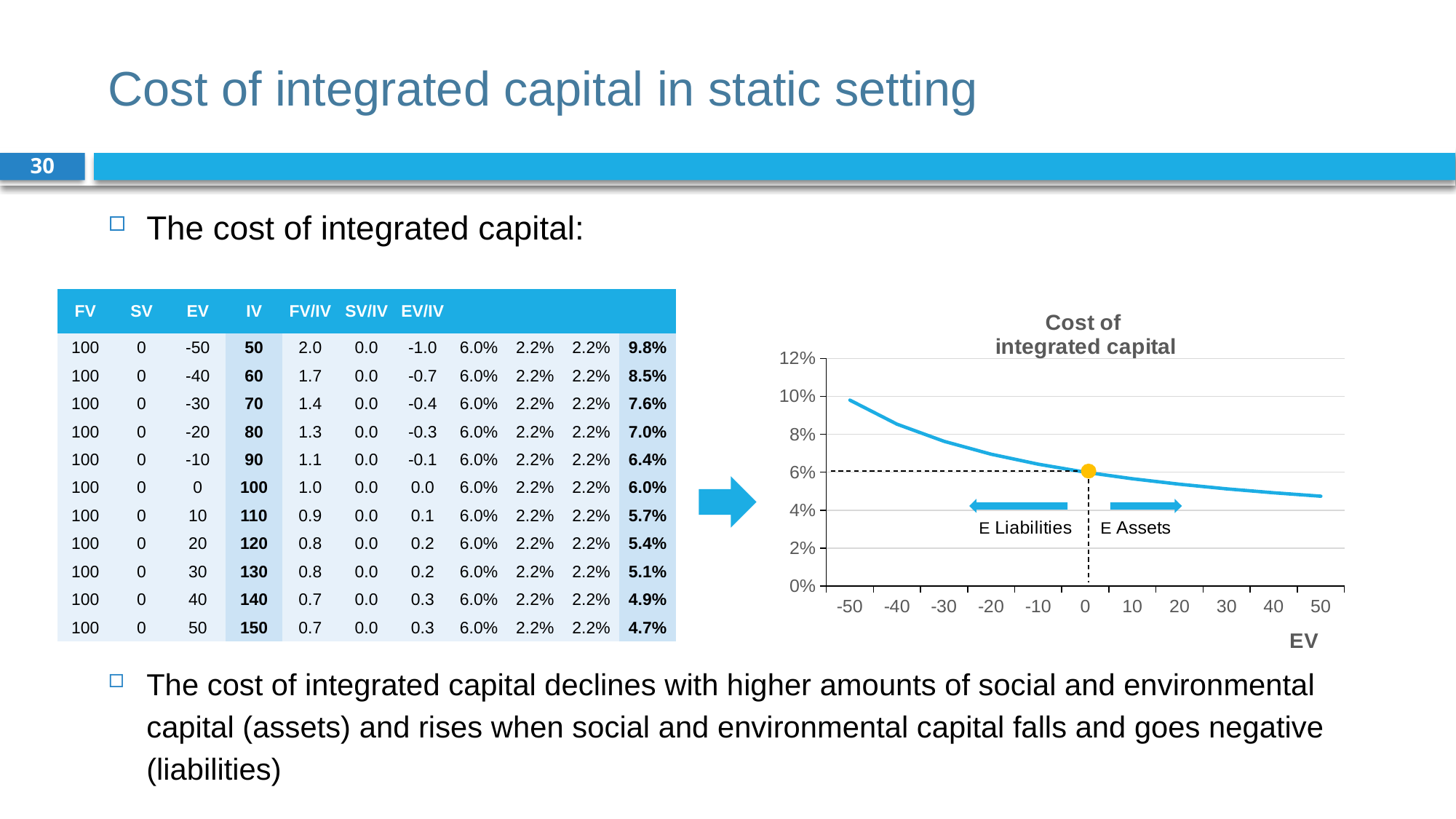
What kind of chart is shown on the slide? line chart At which EV value is the cost of integrated capital highest on the chart? -50 What two labels appear beside the arrows below the curve on the chart? E Liabilities and E Assets Is the cost of integrated capital at EV = -50 greater or less than 8%? greater Does the cost of integrated capital rise or fall as EV increases along the x axis? fall How many tick labels are shown on the EV axis of the chart? 11 Is the cost of integrated capital at EV = 50 greater or less than 6%? less Is the cost of integrated capital at EV = -30 greater or less than 6%? greater At which EV value is the cost of integrated capital lowest on the chart? 50 What is the cost of integrated capital at EV = 0 on the chart? 6% Which has a higher cost of integrated capital on the chart, EV = -40 or EV = 40? EV = -40 What is the title of the chart? Cost of integrated capital